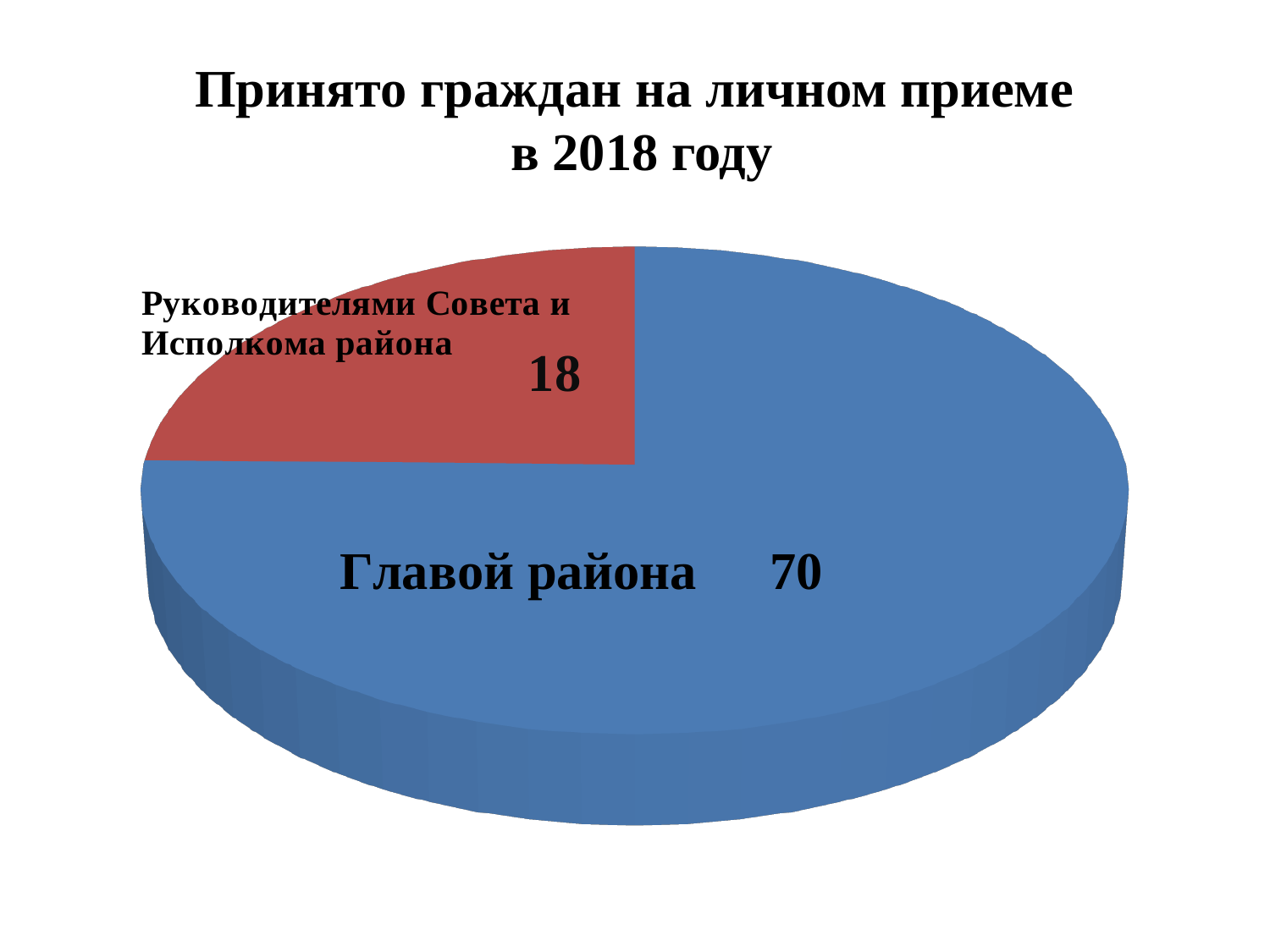
What is the total of the two slices in the pie chart? 88 What type of chart is shown on the slide? pie chart Which category has the smallest slice? Руководителями Совета и Исполкома района Which category has the largest slice? Главой района How many slices does the pie chart have? 2 Which is larger: the value for "Главой района" or for "Руководителями Совета и Исполкома района"? Главой района What colour is the slice for "Главой района"? blue What is the difference between the values for "Главой района" and "Руководителями Совета и Исполкома района"? 52 What is the value for "Главой района"? 70 What is the title of the chart? Принято граждан на личном приеме в 2018 году What is the value for "Руководителями Совета и Исполкома района"? 18